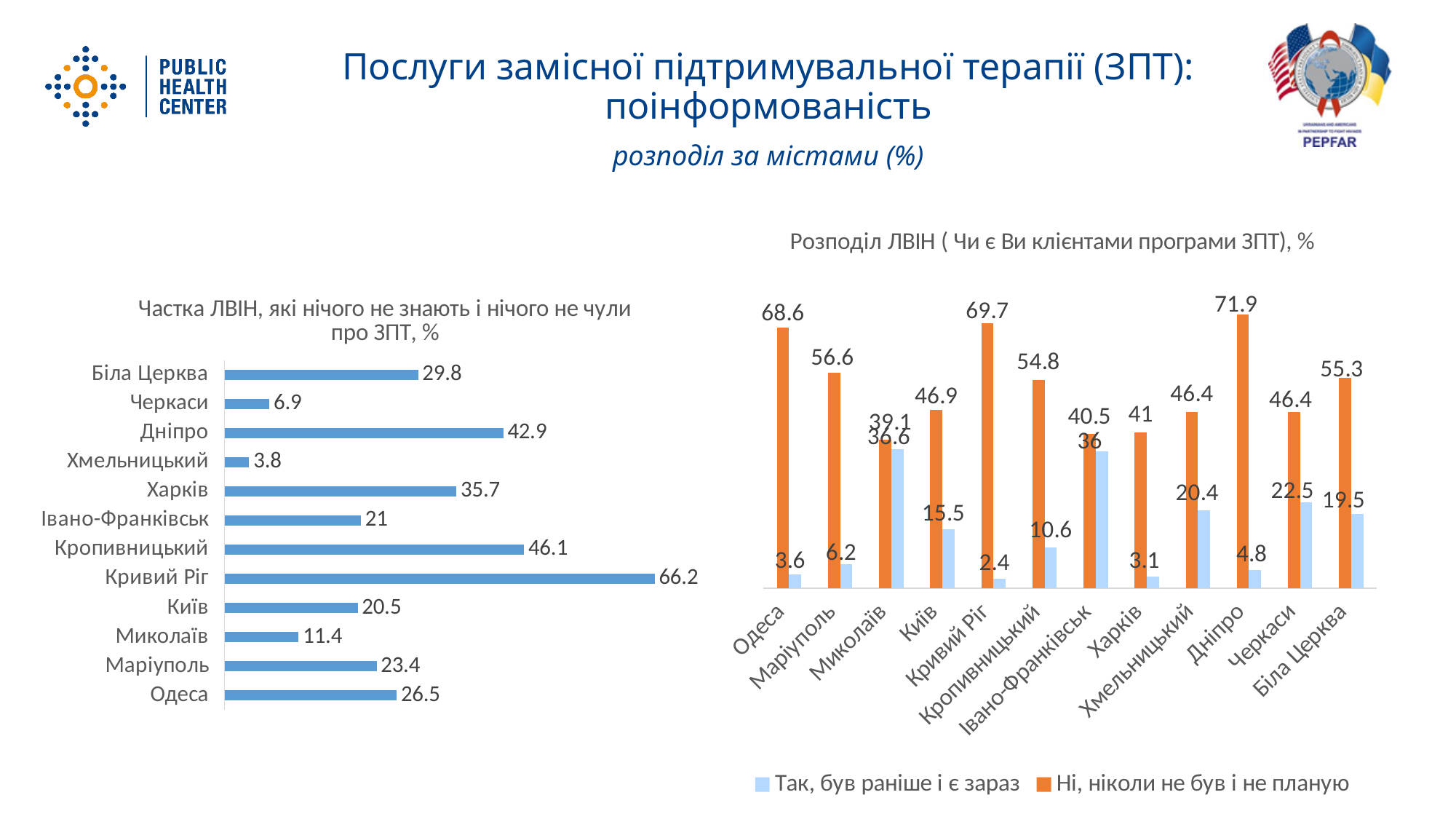
In the left chart (Частка ЛВІН, які нічого не знають і нічого не чули про ЗПТ, %), what is the difference between Дніпро and Харків? 7.2 In the left chart (Частка ЛВІН, які нічого не знають і нічого не чули про ЗПТ, %), which city has the lowest value? Хмельницький In the right chart (Розподіл ЛВІН (Чи є Ви клієнтами програми ЗПТ), %), which is larger for Черкаси: 'Так, був раніше і є зараз' or 'Ні, ніколи не був і не планую'? Ні, ніколи не був і не планую What type of chart is the left chart (Частка ЛВІН, які нічого не знають і нічого не чули про ЗПТ, %)? Bar chart In the right chart (Розподіл ЛВІН (Чи є Ви клієнтами програми ЗПТ), %), how many series does the legend list? 2 In the left chart (Частка ЛВІН, які нічого не знають і нічого не чули про ЗПТ, %), which city has the highest value? Кривий Ріг In the right chart (Розподіл ЛВІН (Чи є Ви клієнтами програми ЗПТ), %), which city has the lowest value for 'Так, був раніше і є зараз'? Кривий Ріг In the left chart (Частка ЛВІН, які нічого не знають і нічого не чули про ЗПТ, %), how many cities are shown? 12 In the left chart (Частка ЛВІН, які нічого не знають і нічого не чули про ЗПТ, %), what is the value for Кривий Ріг? 66.2 In the right chart (Розподіл ЛВІН (Чи є Ви клієнтами програми ЗПТ), %), what is the difference between the 'Ні, ніколи не був і не планую' values for Одеса and Маріуполь? 12 In the right chart (Розподіл ЛВІН (Чи є Ви клієнтами програми ЗПТ), %), what is the value of 'Так, був раніше і є зараз' for Миколаїв? 36.6 In the right chart (Розподіл ЛВІН (Чи є Ви клієнтами програми ЗПТ), %), what is the value of 'Ні, ніколи не був і не планую' for Дніпро? 71.9